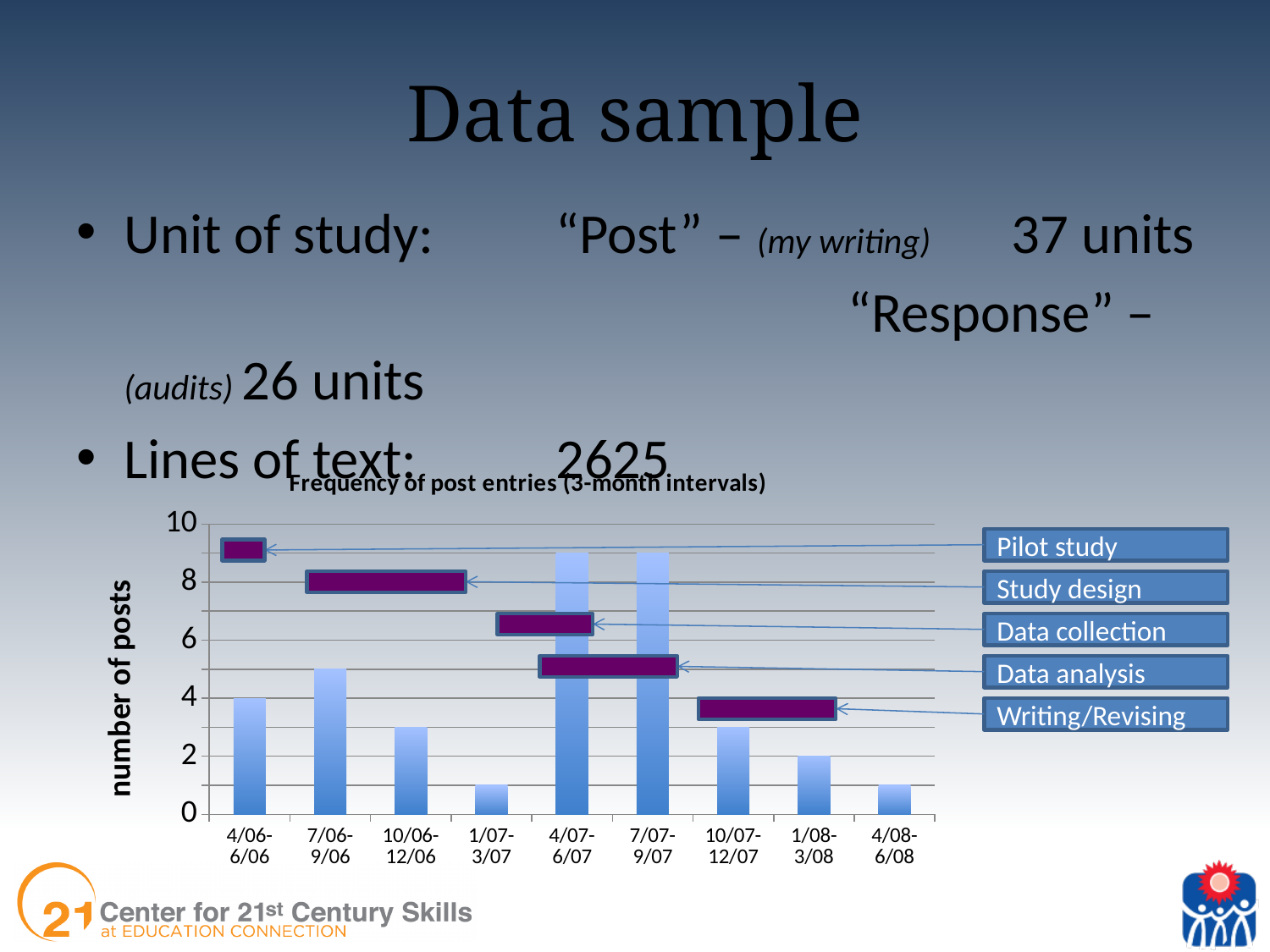
What is the title of the chart? Frequency of post entries (3-month intervals) Is the number of posts for 1/07-3/07 greater or less than 2? less How many posts were made in the 4/06-6/06 interval? 4 Is the number of posts for 7/06-9/06 greater or less than 4? greater How many posts were made in the 1/08-3/08 interval? 2 From the 7/07-9/07 interval to the 4/08-6/08 interval, do the number of posts rise or fall? fall How many 3-month intervals are shown on the x axis of the chart? 9 Which interval has more posts, 7/06-9/06 or 10/06-12/06? 7/06-9/06 What type of chart is shown on the slide? bar chart What is the label on the vertical axis of the chart? number of posts Is the number of posts for 10/07-12/07 greater or less than 4? less